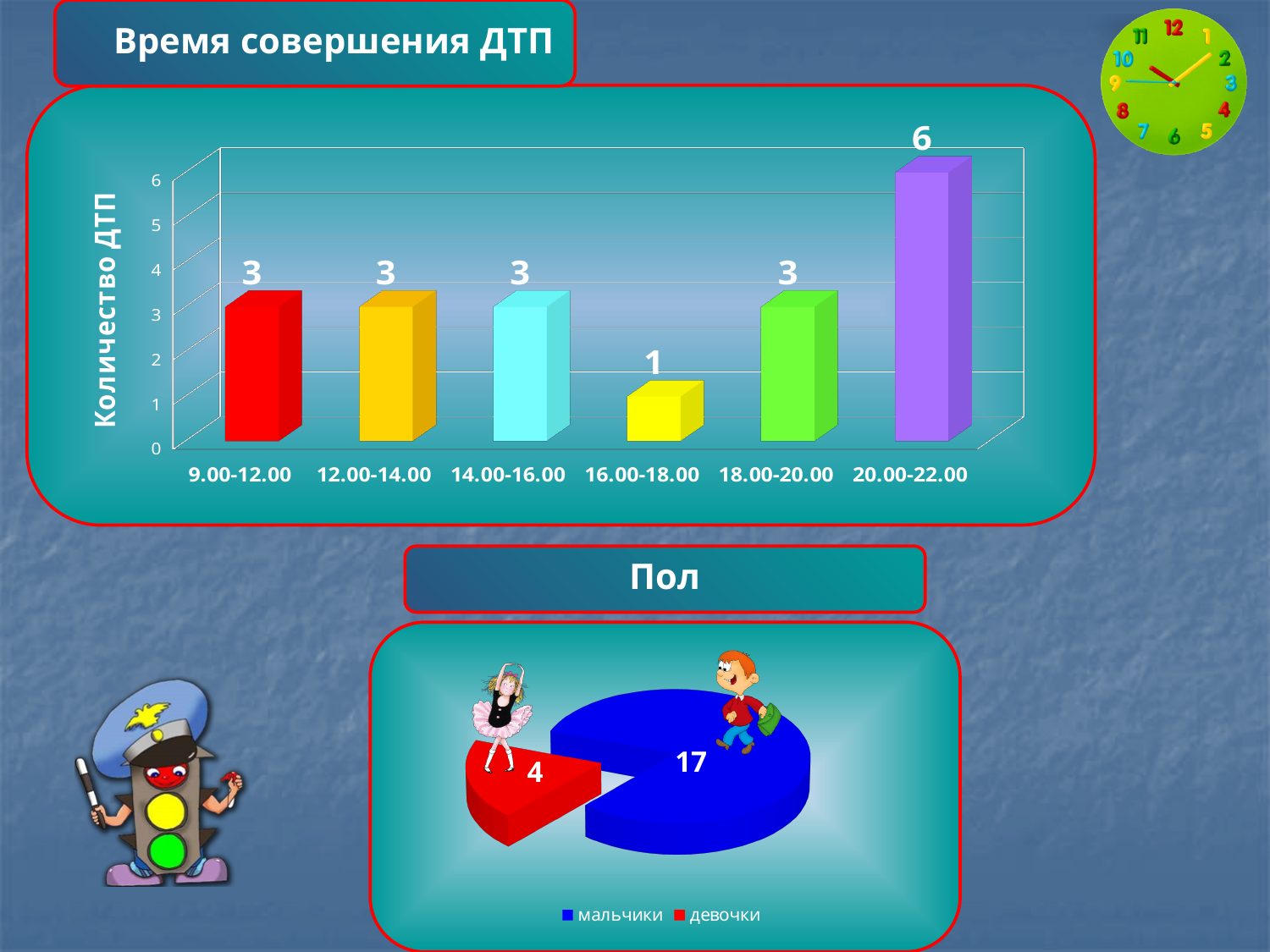
In the chart titled 'Время совершения ДТП', what is the value for 16.00-18.00? 1 In the chart titled 'Время совершения ДТП', what is the value for 20.00-22.00? 6 In the chart titled 'Время совершения ДТП', how many time intervals are shown on the x axis? 6 In the chart titled 'Пол', what type of chart is used? pie chart In the chart titled 'Время совершения ДТП', which time interval has the lowest number of accidents? 16.00-18.00 In the chart titled 'Пол', what is the value for девочки? 4 In the chart titled 'Время совершения ДТП', which time interval has the highest number of accidents? 20.00-22.00 In the chart titled 'Время совершения ДТП', what is the label of the vertical axis? Количество ДТП In the chart titled 'Время совершения ДТП', what type of chart is used? bar chart In the chart titled 'Время совершения ДТП', what is the difference between the values for 20.00-22.00 and 16.00-18.00? 5 In the chart titled 'Пол', which is larger, мальчики or девочки? мальчики In the chart titled 'Пол', what is the value for мальчики? 17